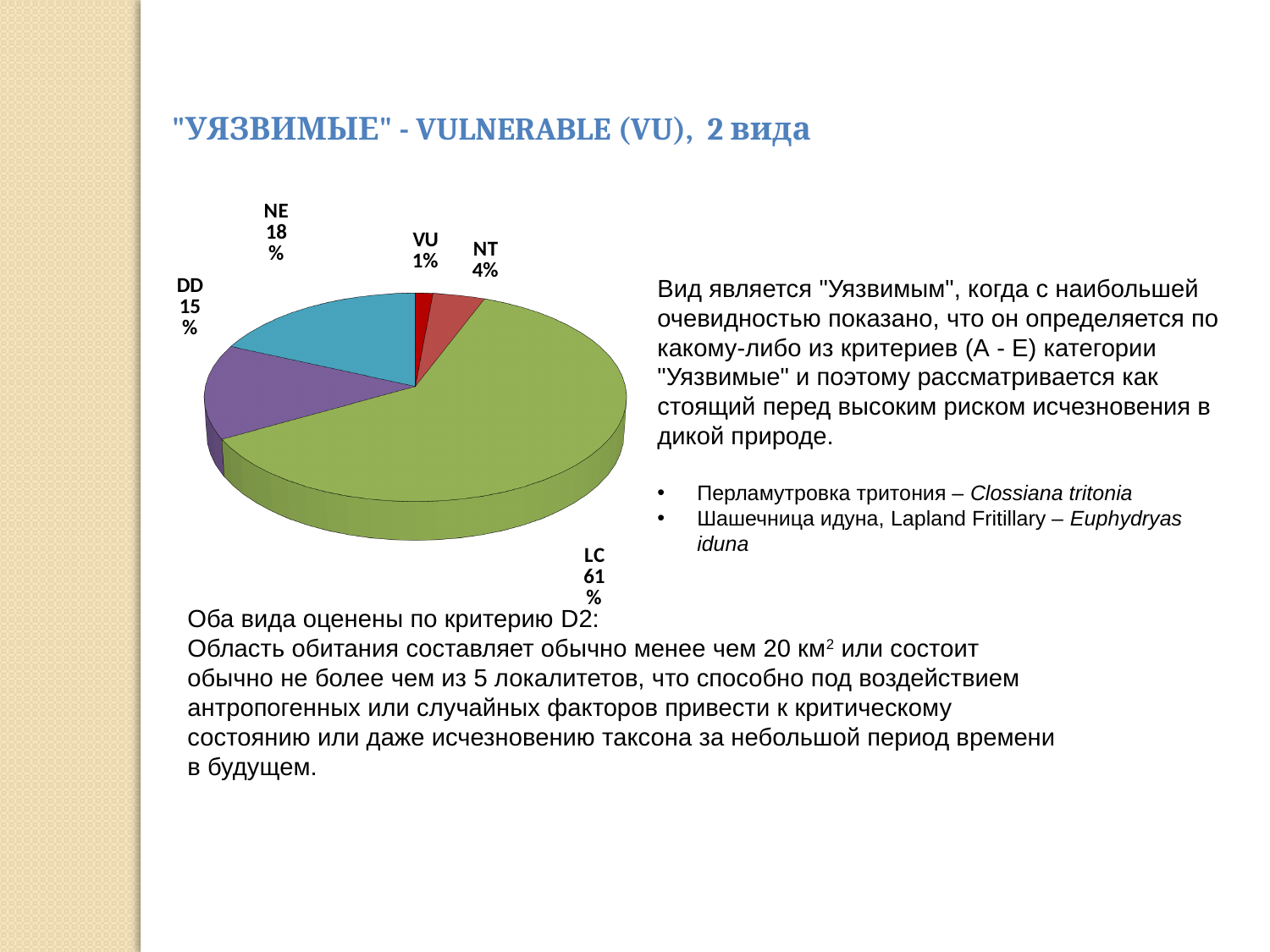
What share of the pie does the VU slice represent? 1% What share of the pie does the LC slice represent? 61% What is the difference in percentage points between the LC and NE slices? 43 Which category has the smallest slice of the pie? VU How many slices does the pie chart have? 5 What kind of chart is shown on the slide? pie chart What share of the pie does the NE slice represent? 18% Which category has the largest slice of the pie? LC What colour is the LC slice of the pie chart? green Which slice is larger, NE or DD? NE